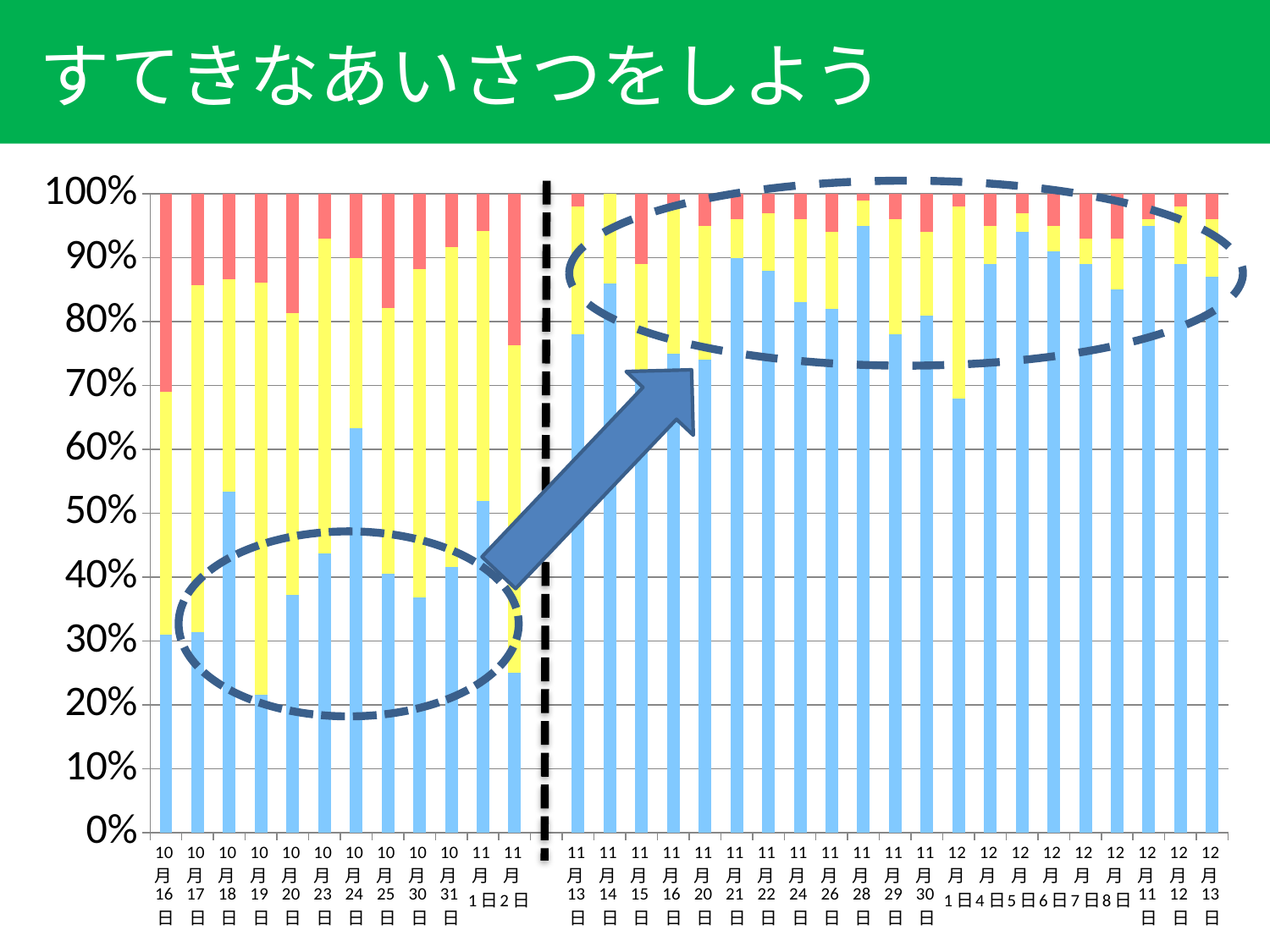
How many bars are to the right of the black dashed vertical line? 21 Is the blue segment for 10月19日 greater or less than 30%? less Is the blue segment for 10月16日 greater or less than 40%? less Is the blue segment for 11月28日 greater or less than 90%? greater Which has the larger blue segment, 10月16日 or 11月13日? 11月13日 How many bars are to the left of the black dashed vertical line? 12 What kind of chart is shown on the slide? stacked bar chart How many bars (dates) are plotted in the chart? 33 Does the blue segment generally rise or fall from the earliest date to the latest date? rise What is the highest value shown on the vertical axis? 100%